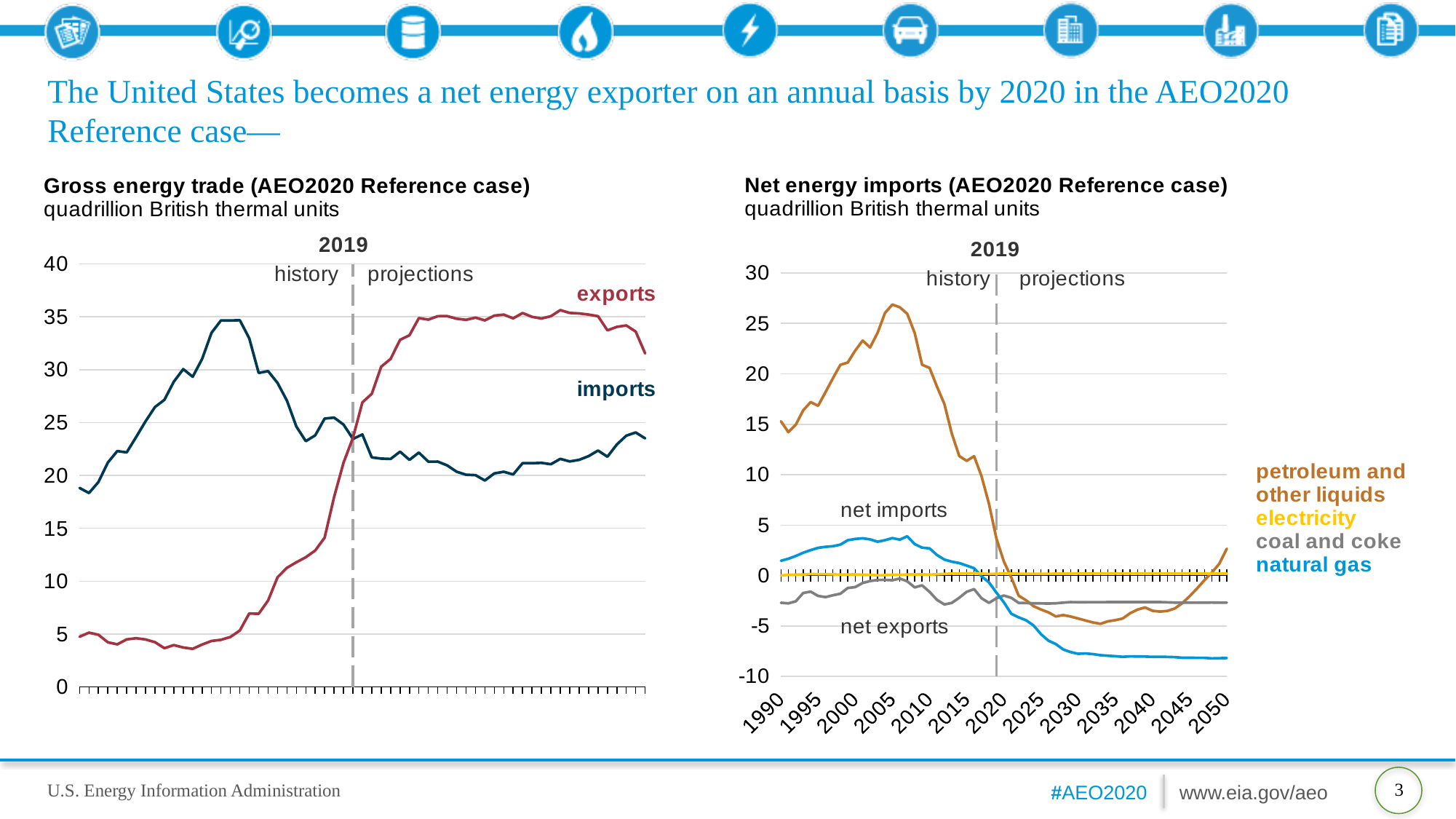
On the 'Net energy imports' chart, in 2050 which is larger, petroleum and other liquids or natural gas? petroleum and other liquids What year does the dashed vertical line separating history from projections mark on both charts? 2019 On the 'Net energy imports' chart, is the peak value of petroleum and other liquids greater or less than 25? greater On the 'Net energy imports' chart, does natural gas rise or fall between 2015 and 2030? fall On the 'Net energy imports' chart, which series has the lowest value in 2050? natural gas On the 'Net energy imports' chart, is the value for natural gas in 2050 greater or less than -5? less On the 'Gross energy trade' chart, at the right end of the projections, which is larger, exports or imports? exports How many series are plotted on the 'Gross energy trade (AEO2020 Reference case)' chart? 2 How many series does the legend list on the 'Net energy imports (AEO2020 Reference case)' chart? 4 On the 'Net energy imports' chart, which series has the highest value in 2005? petroleum and other liquids On the 'Gross energy trade' chart, is the peak value of imports greater or less than 30? greater What kind of chart is the 'Gross energy trade (AEO2020 Reference case)' chart? line chart